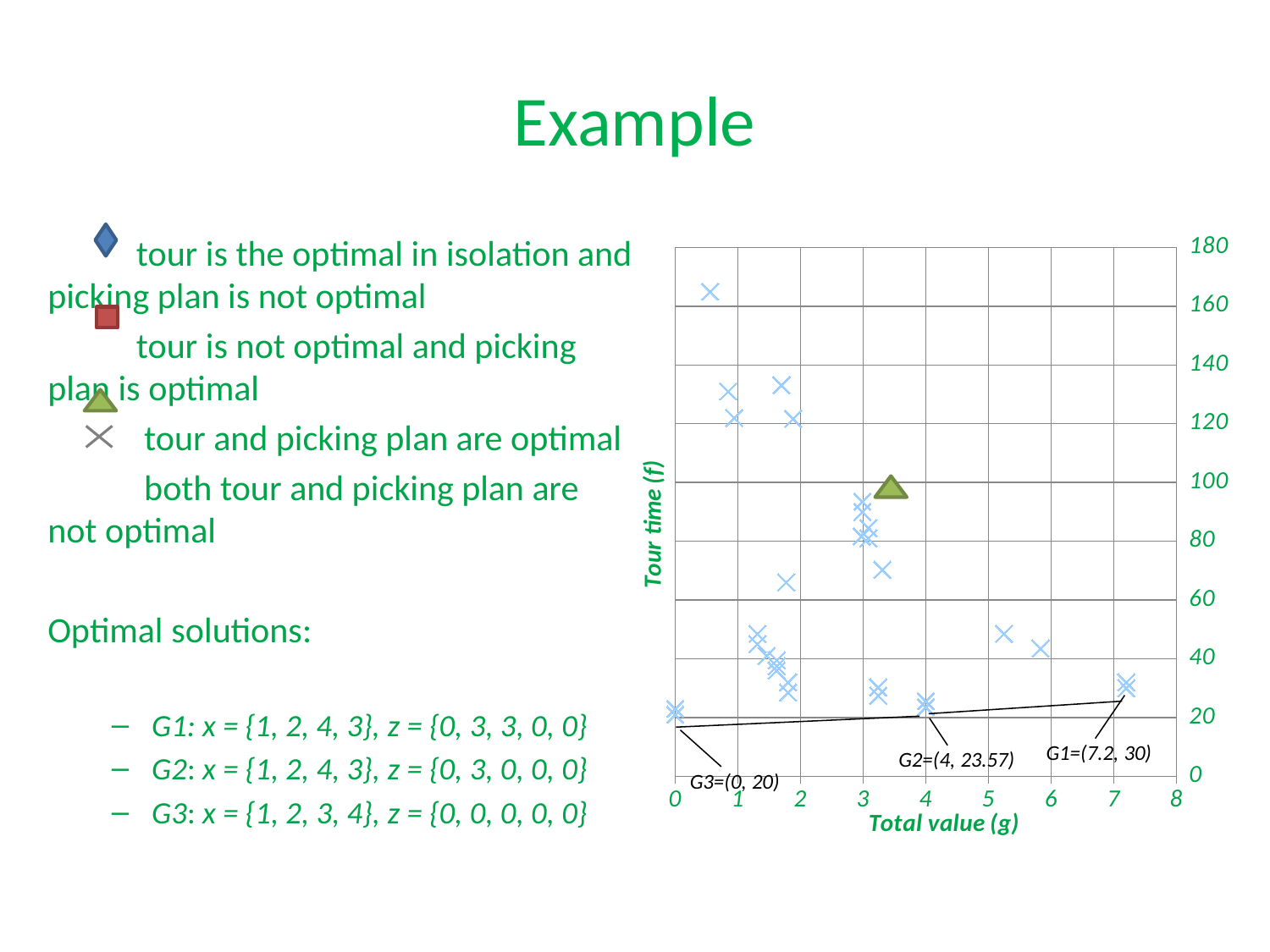
What is the difference in total value (g) between G1 and G2? 3.2 What kind of chart is shown on the slide? scatter chart What is the difference in tour time (f) between G1 and G3? 10 Is the tour time (f) of the green triangle marker greater or less than 80? greater How many points on the chart are labelled with their coordinates? 3 Among the labelled points G1, G2 and G3, which has the lowest tour time (f)? G3 What is the total value (g) of the point labelled G3? 0 Which has the larger tour time (f), G1 or G2? G1 What are the coordinates of the point labelled G1? (7.2, 30) What is the title of the y axis of the chart? Tour time (f) What is the tour time (f) of the point labelled G2? 23.57 What is the title of the x axis of the chart? Total value (g)